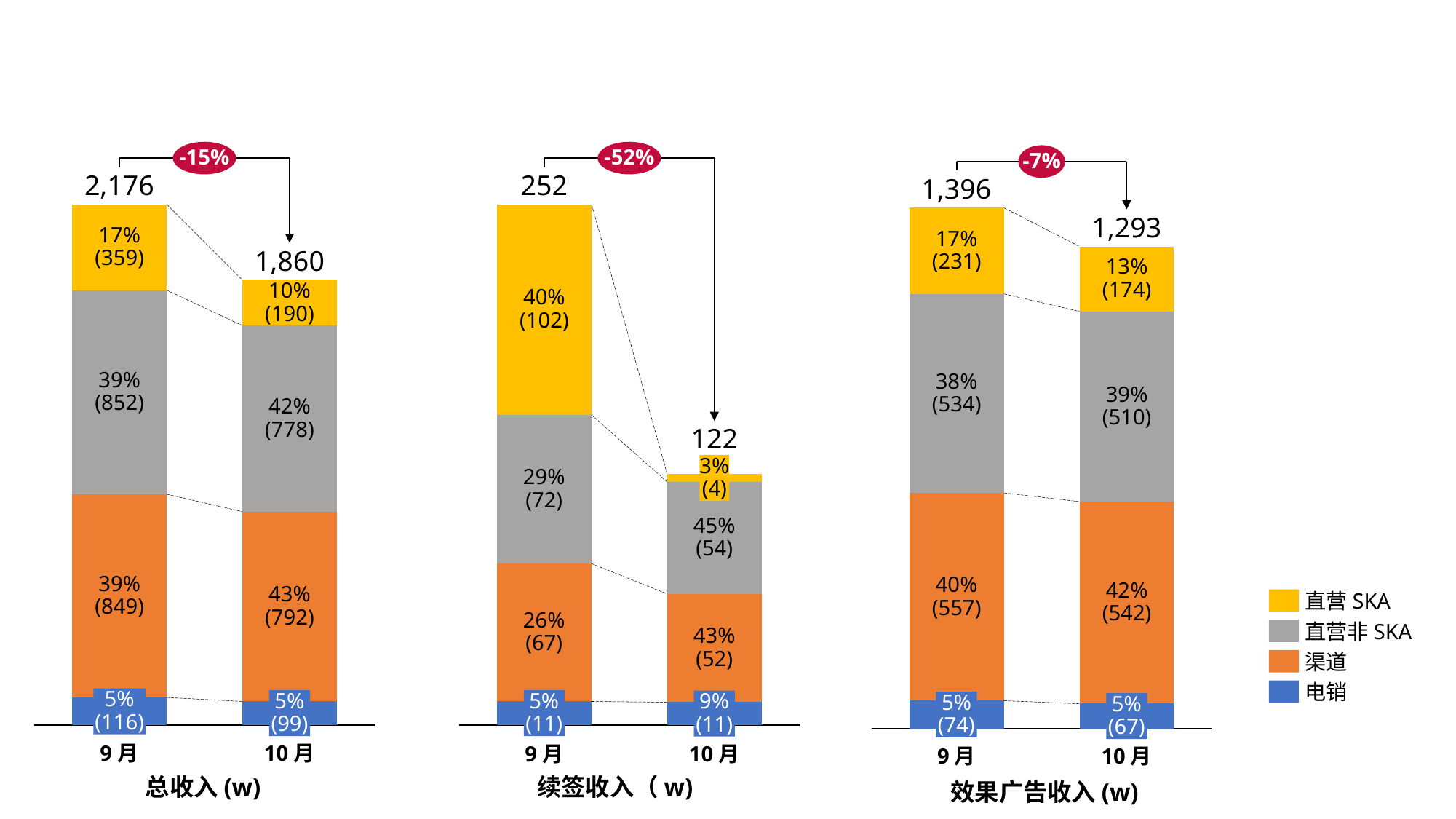
In the 效果广告收入 (w) chart, what is the difference between the 9 月 and 10 月 totals? 103 In the 续签收入 (w) chart, what percentage share does 直营 SKA have in 9 月? 40% How many series does the legend list? 4 In the 总收入 (w) chart, what is the total for the 9 月 bar? 2,176 In the 总收入 (w) chart, which segment is the largest in the 9 月 bar? 直营非 SKA In the 效果广告收入 (w) chart, what value is shown for 直营非 SKA in 10 月? 510 What percentage change is shown above the 续签收入 (w) chart? -52% In the 效果广告收入 (w) chart, is the 渠道 value larger in 9 月 or 10 月? 9 月 In the 总收入 (w) chart, what value is shown for 渠道 in 10 月? 792 What type of chart is used for 总收入 (w)? Stacked bar chart In the 续签收入 (w) chart, what is the total for the 10 月 bar? 122 In the 续签收入 (w) chart, which segment is the smallest in the 10 月 bar? 直营 SKA